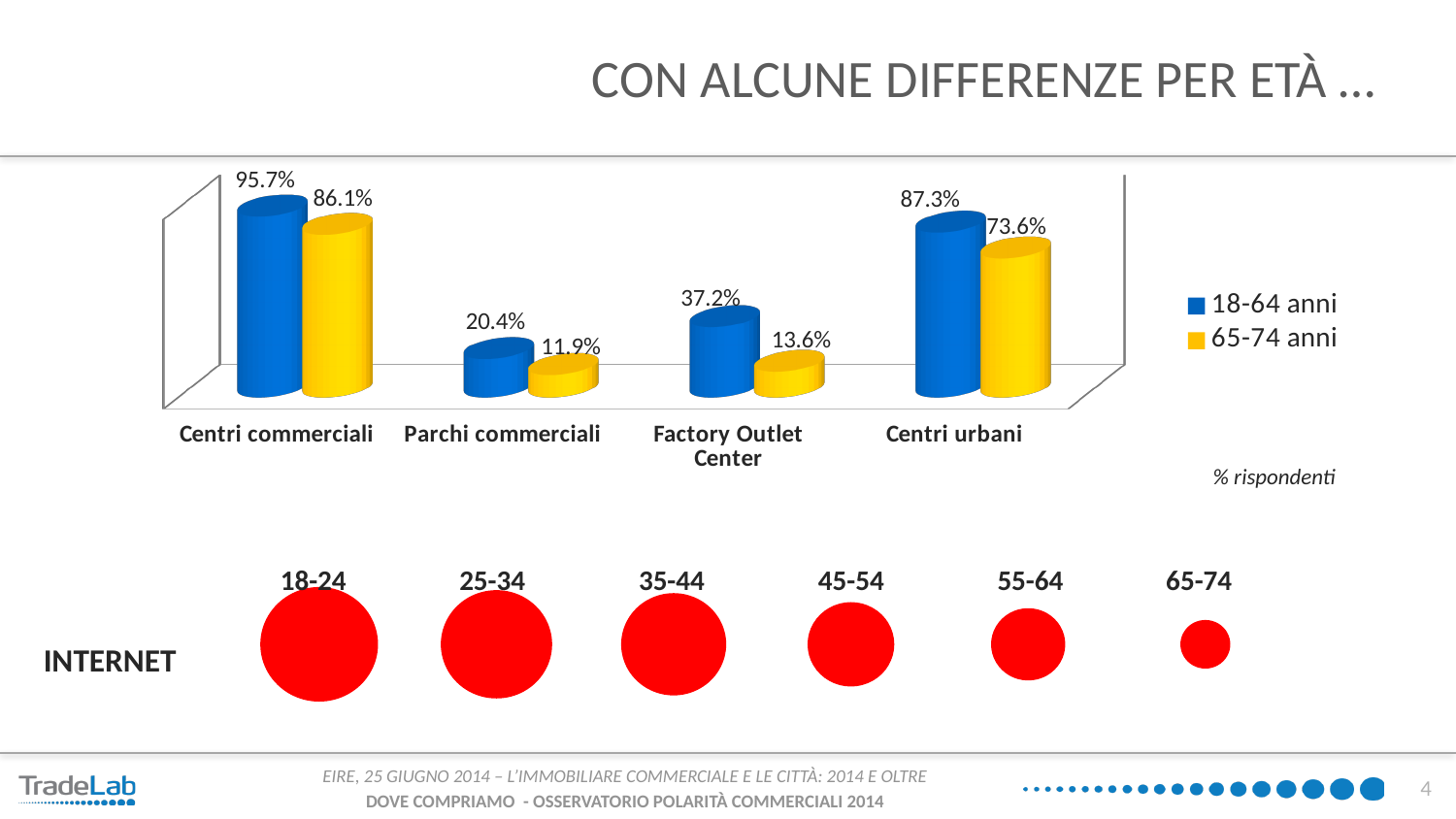
In the bar chart, what is the value for Centri commerciali in the 18-64 anni series? 95.7% In the bar chart, what is the value for Factory Outlet Center in the 18-64 anni series? 37.2% In the bar chart, which category has the highest value for the 18-64 anni series? Centri commerciali In the bar chart, what is the difference between the 18-64 anni and 65-74 anni values for Factory Outlet Center? 23.6% In the bar chart, what is the value for Parchi commerciali in the 65-74 anni series? 11.9% How many series does the legend of the bar chart list? 2 What type of chart is the upper chart on the slide? Bar chart In the bar chart, which is larger: the 65-74 anni value for Centri commerciali or the 18-64 anni value for Centri urbani? 18-64 anni value for Centri urbani In the bar chart, what is the difference between the 18-64 anni and 65-74 anni values for Centri urbani? 13.7% In the bar chart, which category has the lowest value for the 65-74 anni series? Parchi commerciali How many categories are shown on the x axis of the bar chart? 4 In the bar chart, what is the value for Centri urbani in the 65-74 anni series? 73.6%